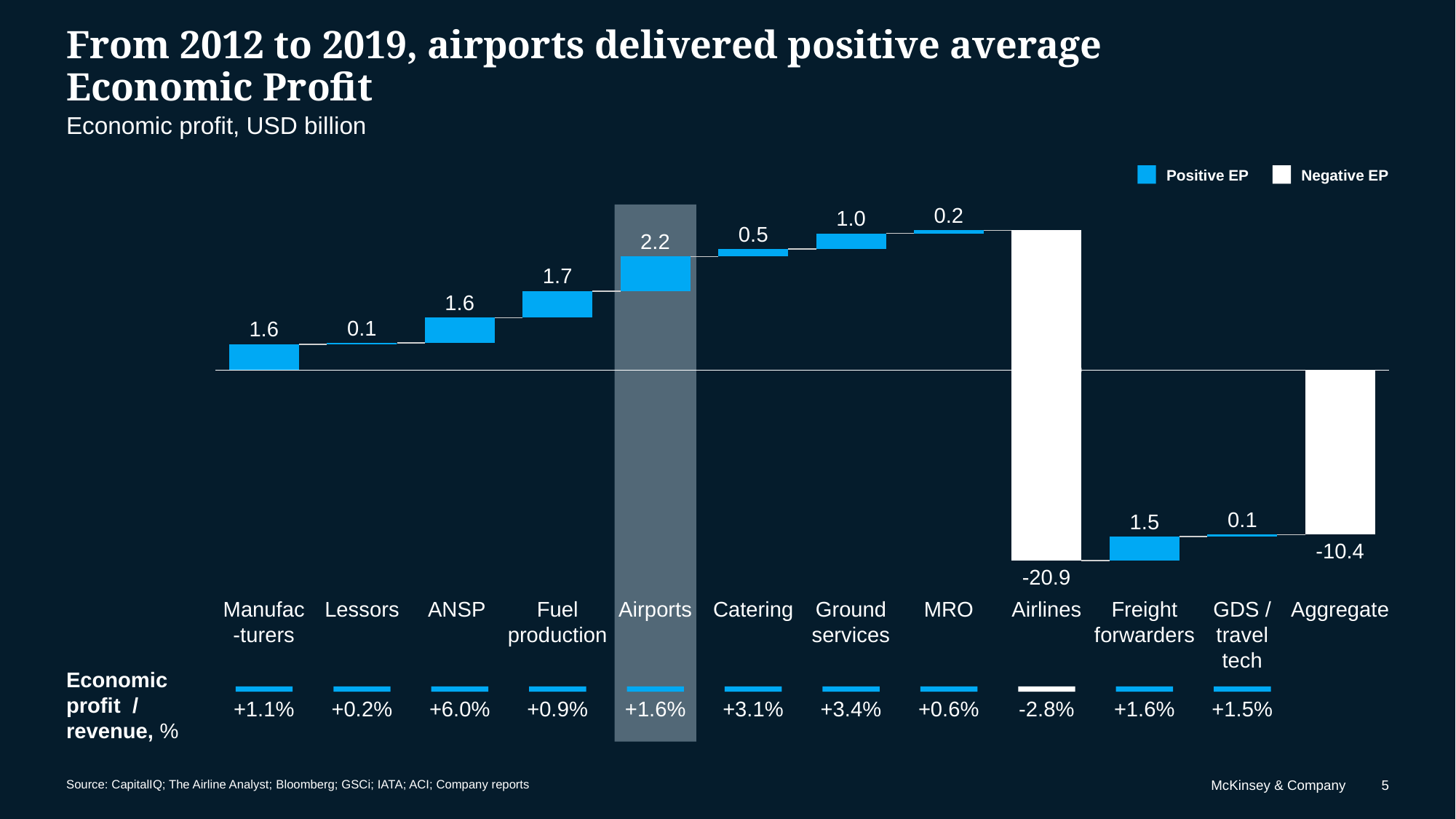
How many entries does the legend list? 2 What is the economic profit for Airlines, in USD billion? -20.9 What is the Aggregate economic profit shown at the right of the chart? -10.4 Which segment has the highest positive economic profit? Airports What is the difference between the economic profit of Airports and Fuel production, in USD billion? 0.5 How many segment bars are plotted in the chart, including the Aggregate bar? 12 Which colour does the legend assign to Negative EP? White What is the economic profit for Airports, in USD billion? 2.2 What kind of chart is shown on the slide? bar chart (waterfall) What is the economic profit / revenue percentage shown for ANSP? +6.0% Which segment has the lowest economic profit? Airlines Which has a larger economic profit, Catering or Ground services? Ground services